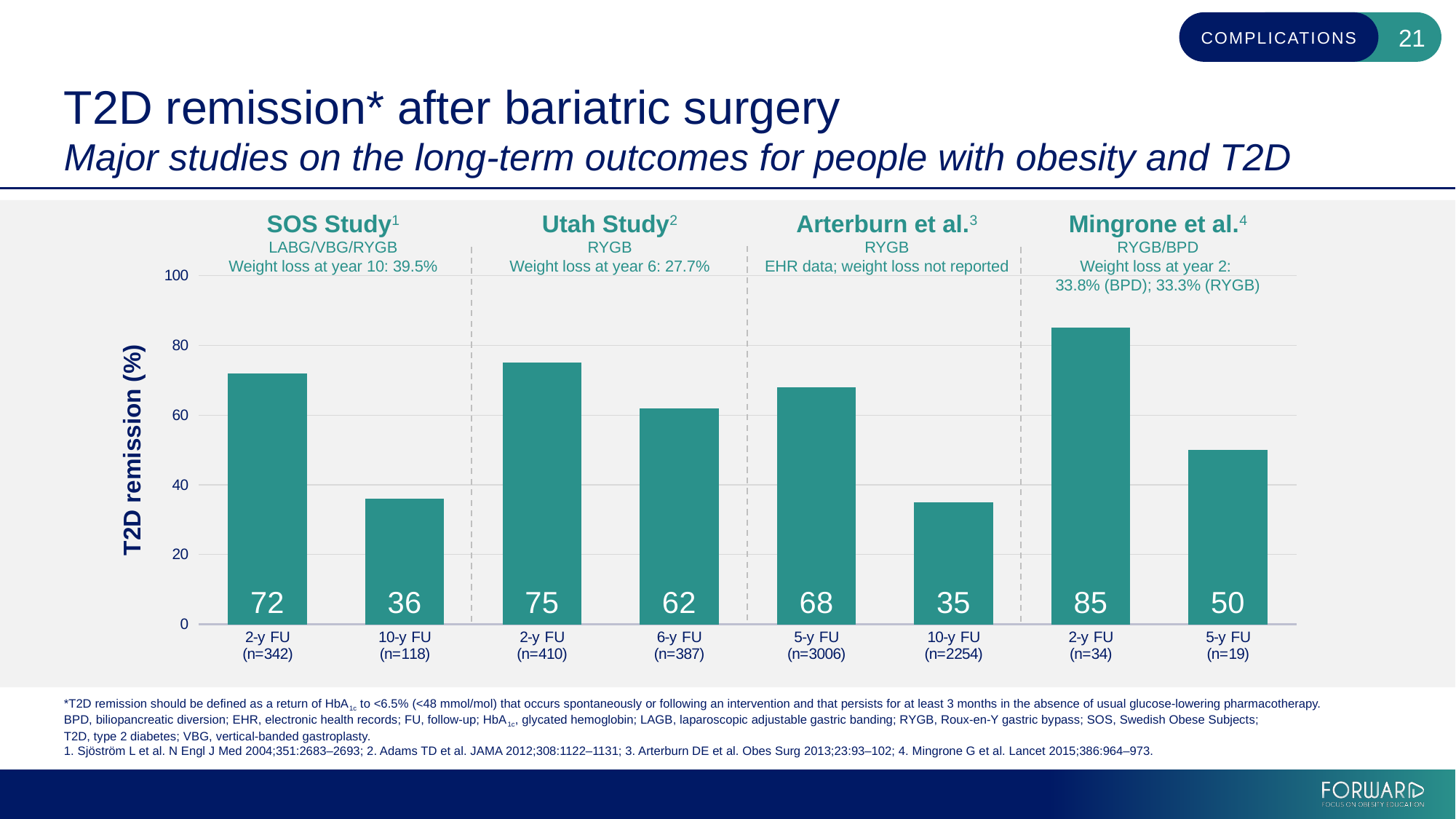
What is the T2D remission (%) for the SOS Study at 2-y FU (n=342)? 72 Is the T2D remission value for Arterburn et al. at 10-y FU greater or less than 40? less Which is larger: T2D remission at 2-y FU in the Utah Study or at 5-y FU in Arterburn et al.? Utah Study 2-y FU What is the T2D remission (%) for the Utah Study at 6-y FU (n=387)? 62 What is the label of the y axis? T2D remission (%) Which bar shows the lowest T2D remission (%)? Arterburn et al. 10-y FU (n=2254) How many bars are plotted in the chart? 8 What type of chart is shown on the slide? bar chart What is the difference in T2D remission (%) between the SOS Study 2-y FU and 10-y FU bars? 36 What is the difference in T2D remission (%) between the Mingrone et al. 2-y FU and 5-y FU bars? 35 What is the T2D remission (%) for Mingrone et al. at 5-y FU (n=19)? 50 Which bar shows the highest T2D remission (%)? Mingrone et al. 2-y FU (n=34)